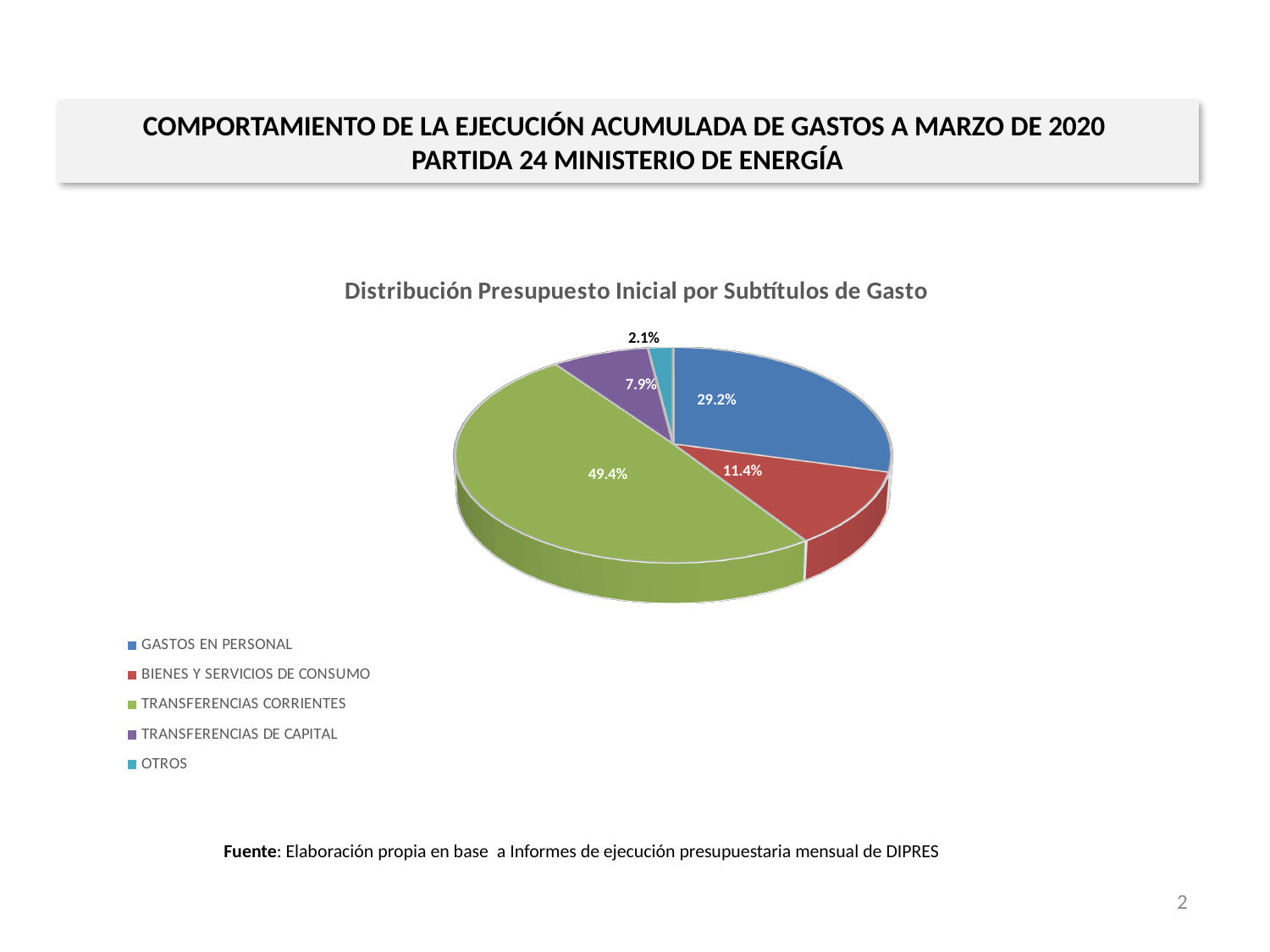
How many categories does the legend list? 5 Which is larger, the share for BIENES Y SERVICIOS DE CONSUMO or the share for TRANSFERENCIAS DE CAPITAL? BIENES Y SERVICIOS DE CONSUMO Which category has the largest share of the pie? TRANSFERENCIAS CORRIENTES What kind of chart is shown on the slide? pie chart What is the share for TRANSFERENCIAS CORRIENTES? 49.4% Which category has the smallest share of the pie? OTROS What is the title of the chart? Distribución Presupuesto Inicial por Subtítulos de Gasto What is the difference between the shares of TRANSFERENCIAS CORRIENTES and GASTOS EN PERSONAL? 20.2% What is the share for BIENES Y SERVICIOS DE CONSUMO? 11.4% What is the share for TRANSFERENCIAS DE CAPITAL? 7.9% What is the share for OTROS? 2.1% What is the share for GASTOS EN PERSONAL? 29.2%